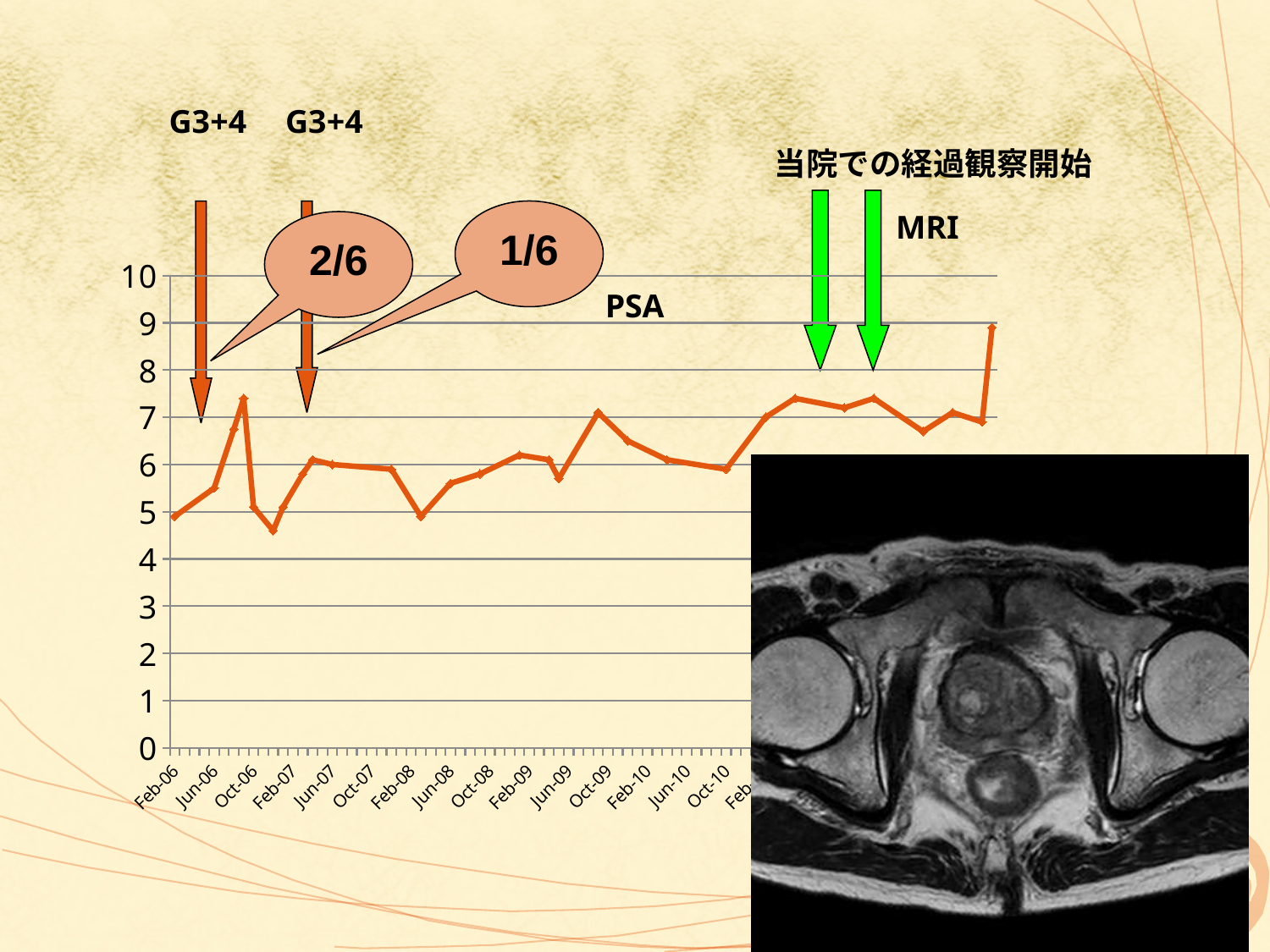
What label is written next to the plotted line on the chart? PSA What kind of chart is shown on the slide? line chart Is the value for Jun-07 greater or less than 7? less Overall, do the PSA values rise or fall from Feb-06 to the right end of the chart? rise Is the highest point of the line at the left end or the right end of the chart? right end Is the value for Jun-06 greater or less than 5? greater Is the final plotted value at the right end of the line greater or less than 8? greater What is the highest value shown on the vertical axis of the chart? 10